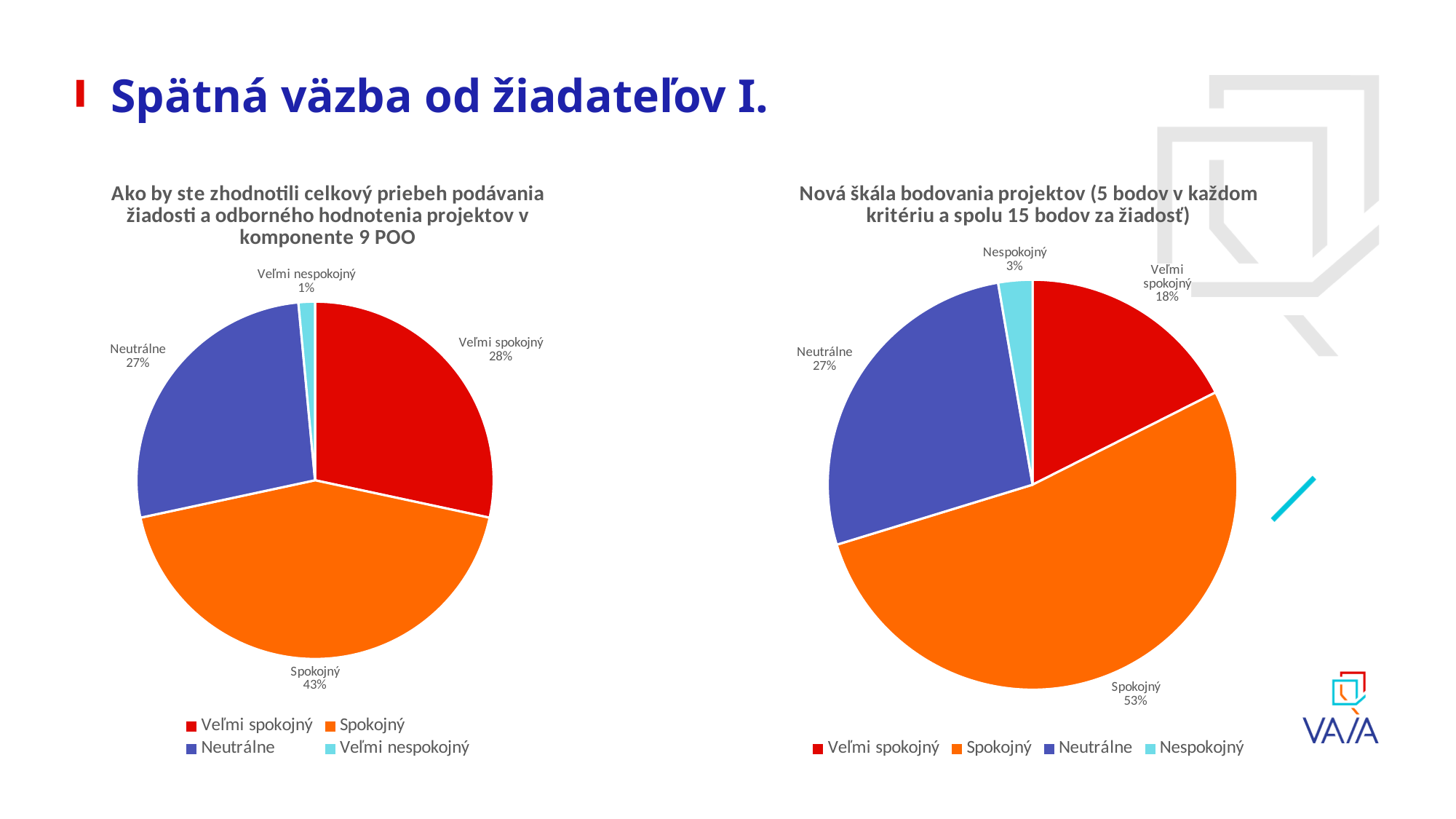
In the right pie chart, what share is labelled for Nespokojný? 3% In the right pie chart, which category has the largest slice? Spokojný In the left pie chart, how many slices does the pie have? 4 In the right pie chart ("Nová škála bodovania projektov..."), what share is labelled for Veľmi spokojný? 18% In the left pie chart, what share is labelled for Veľmi nespokojný? 1% In the left pie chart, which category has the smallest slice? Veľmi nespokojný What type of chart is shown on the left of the slide? Pie chart In the right pie chart, how many entries does the legend list? 4 In the left pie chart ("Ako by ste zhodnotili celkový priebeh podávania žiadosti..."), what share is labelled for Spokojný? 43% In the left pie chart, what is the difference in percentage points between Spokojný and Veľmi spokojný? 15 In the right pie chart, which is larger: Neutrálne or Veľmi spokojný? Neutrálne In the left pie chart, which category has the largest slice? Spokojný